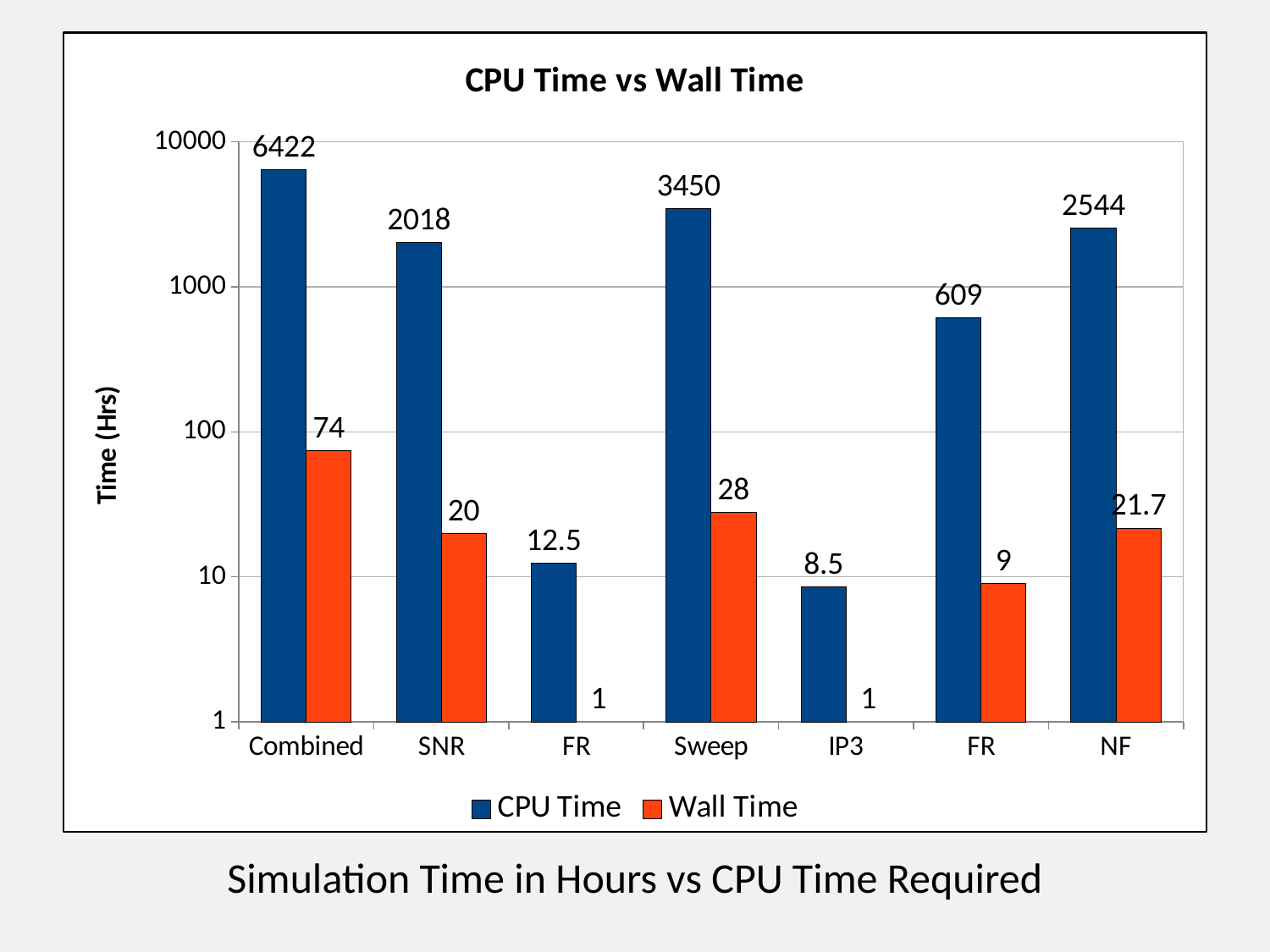
What is the CPU Time value for IP3? 8.5 What kind of chart is shown? bar chart How many categories are shown on the x axis? 7 What is the Wall Time value for NF? 21.7 What is the CPU Time value for Combined? 6422 What is the difference between the Wall Time for Combined and the Wall Time for SNR? 54 Which category has the highest CPU Time? Combined What is the Wall Time value for Sweep? 28 Which category has the lowest CPU Time? IP3 How many series does the legend list? 2 What is the difference between the CPU Time for Combined and the CPU Time for Sweep? 2972 Which has a larger CPU Time, SNR or NF? NF